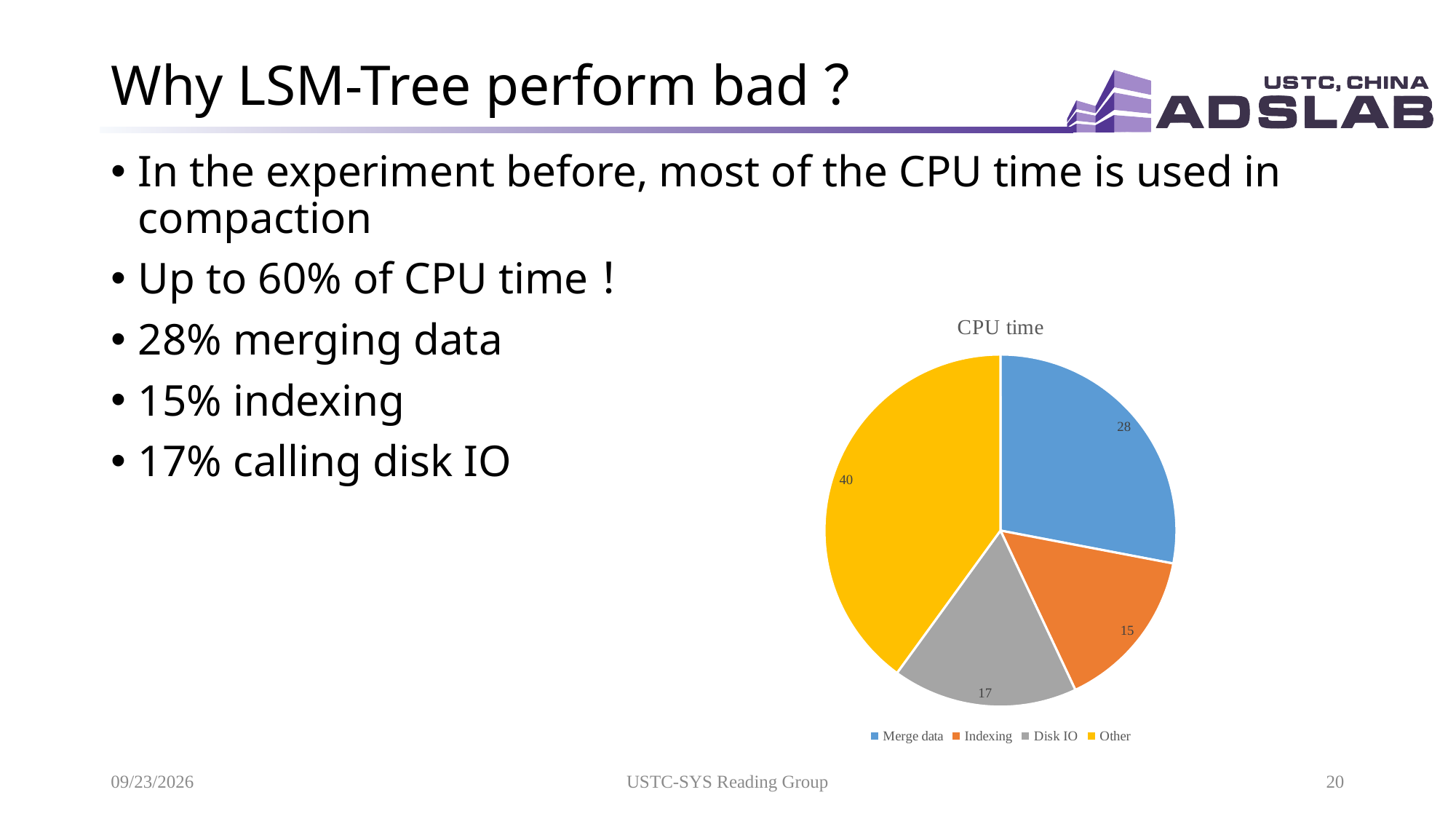
How many slices does the CPU time pie chart have? 4 What is the difference between the values for Other and Merge data in the CPU time pie chart? 12 Which category has the largest slice in the CPU time pie chart? Other What is the title of the chart on the slide? CPU time Which category has the smallest slice in the CPU time pie chart? Indexing What share of the CPU time pie does Merge data represent? 28% What is the value for Merge data in the CPU time pie chart? 28 What is the value for Disk IO in the CPU time pie chart? 17 What is the value for Indexing in the CPU time pie chart? 15 Which is larger in the CPU time pie chart, Disk IO or Indexing? Disk IO What is the value for Other in the CPU time pie chart? 40 What kind of chart is shown on the slide? Pie chart